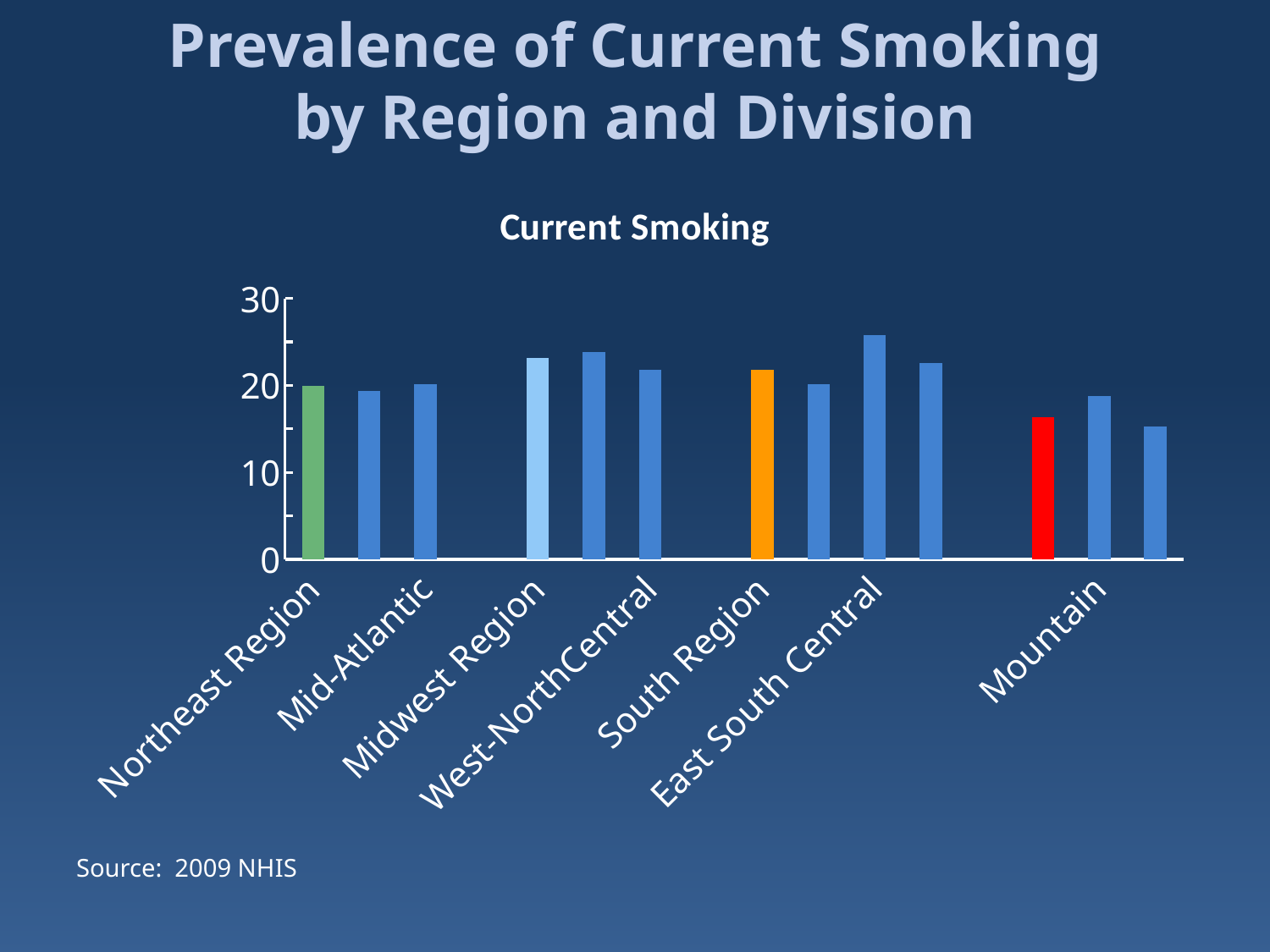
Is the value for East South Central greater or less than 20? greater Is the value for East South Central greater or less than 30? less What is the title of the chart? Current Smoking Is the value for Midwest Region greater or less than 20? greater Which is larger, the value for East South Central or the value for Mountain? East South Central Which labeled category has the highest bar? East South Central What type of chart is shown on the slide? bar chart What colour is the bar for South Region? orange Which is larger, the value for Midwest Region or the value for Mid-Atlantic? Midwest Region How many bars are plotted in the chart? 13